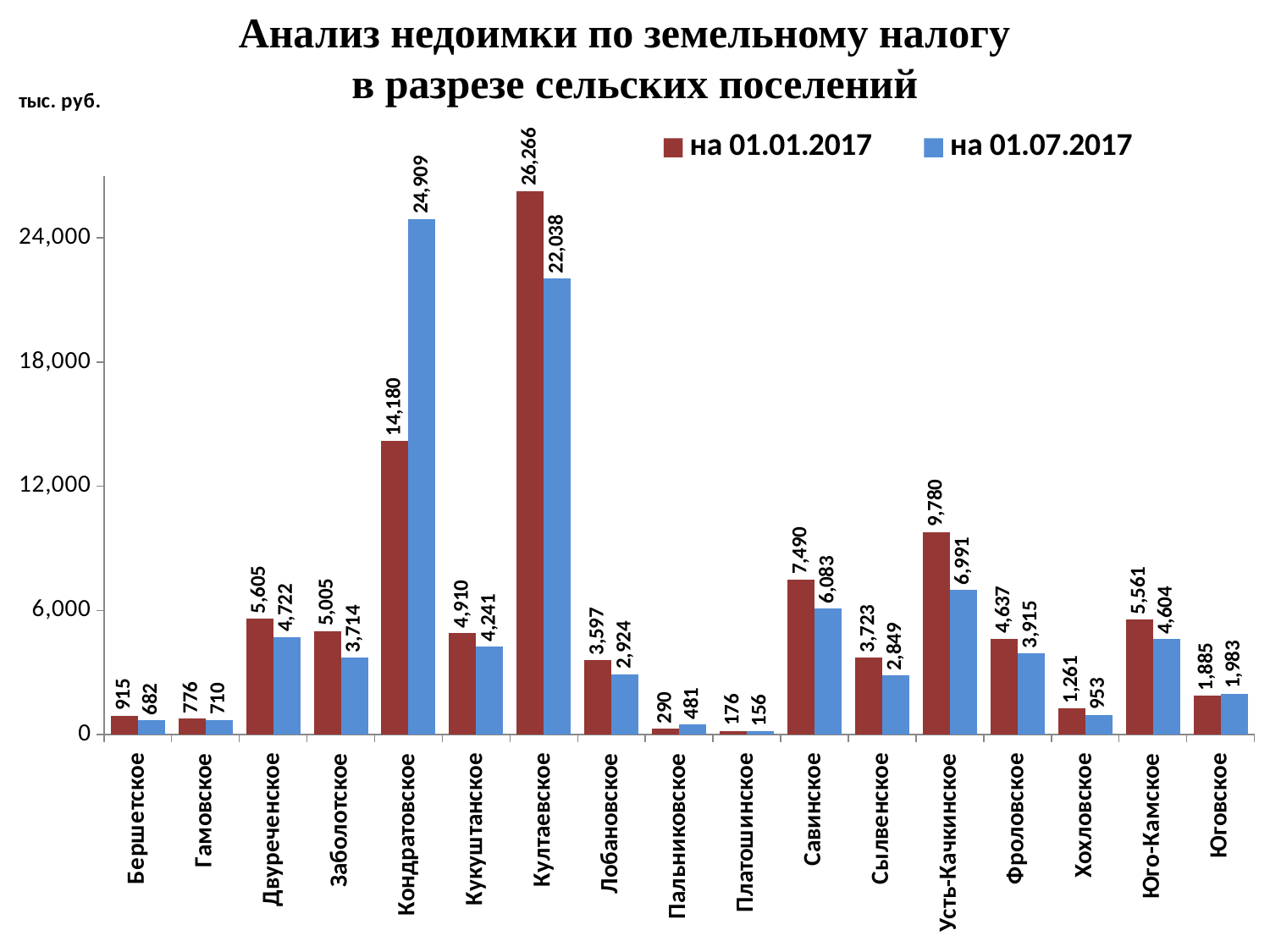
How many categories (settlements) are shown on the x axis? 17 What is the value for Кондратовское in the series на 01.07.2017? 24,909 Which category has the lowest value in the series на 01.07.2017? Платошинское What is the difference between the на 01.07.2017 and на 01.01.2017 values for Кондратовское? 10,729 What is the difference between the на 01.01.2017 and на 01.07.2017 values for Култаевское? 4,228 What is the value for Пальниковское in the series на 01.07.2017? 481 Which category has the highest value in the series на 01.01.2017? Култаевское Which is larger for Юговское: the value на 01.01.2017 or на 01.07.2017? на 01.07.2017 Is the value for Савинское in the series на 01.01.2017 greater or less than 6,000? greater How many series does the legend list? 2 What type of chart is shown on the slide? Bar chart What is the value for Усть-Качкинское in the series на 01.01.2017? 9,780